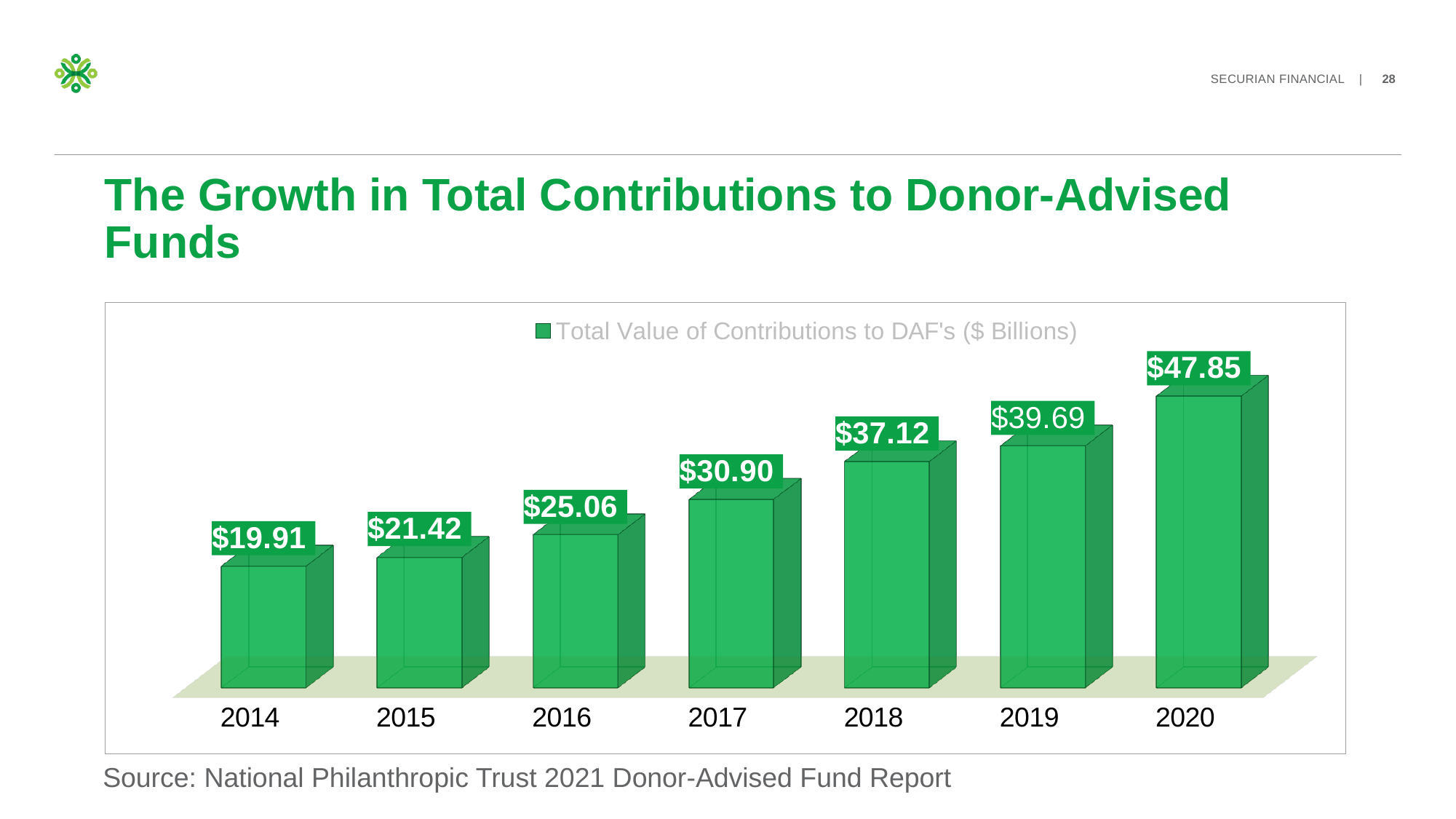
Do the values rise or fall from 2014 to 2020? Rise Which year has a larger value of contributions to DAF's, 2018 or 2016? 2018 What is the total value of contributions to DAF's in 2020? $47.85 What is the difference between the 2016 and 2015 values of contributions to DAF's? $3.64 Which year has the highest total value of contributions to DAF's? 2020 What is the total value of contributions to DAF's in 2014? $19.91 How many series does the legend list? 1 What is the total value of contributions to DAF's in 2017? $30.90 What is the difference between the 2020 and 2019 values of contributions to DAF's? $8.16 How many years are shown on the x axis of the chart? 7 Which year has the lowest total value of contributions to DAF's? 2014 What kind of chart is shown on the slide? Bar chart